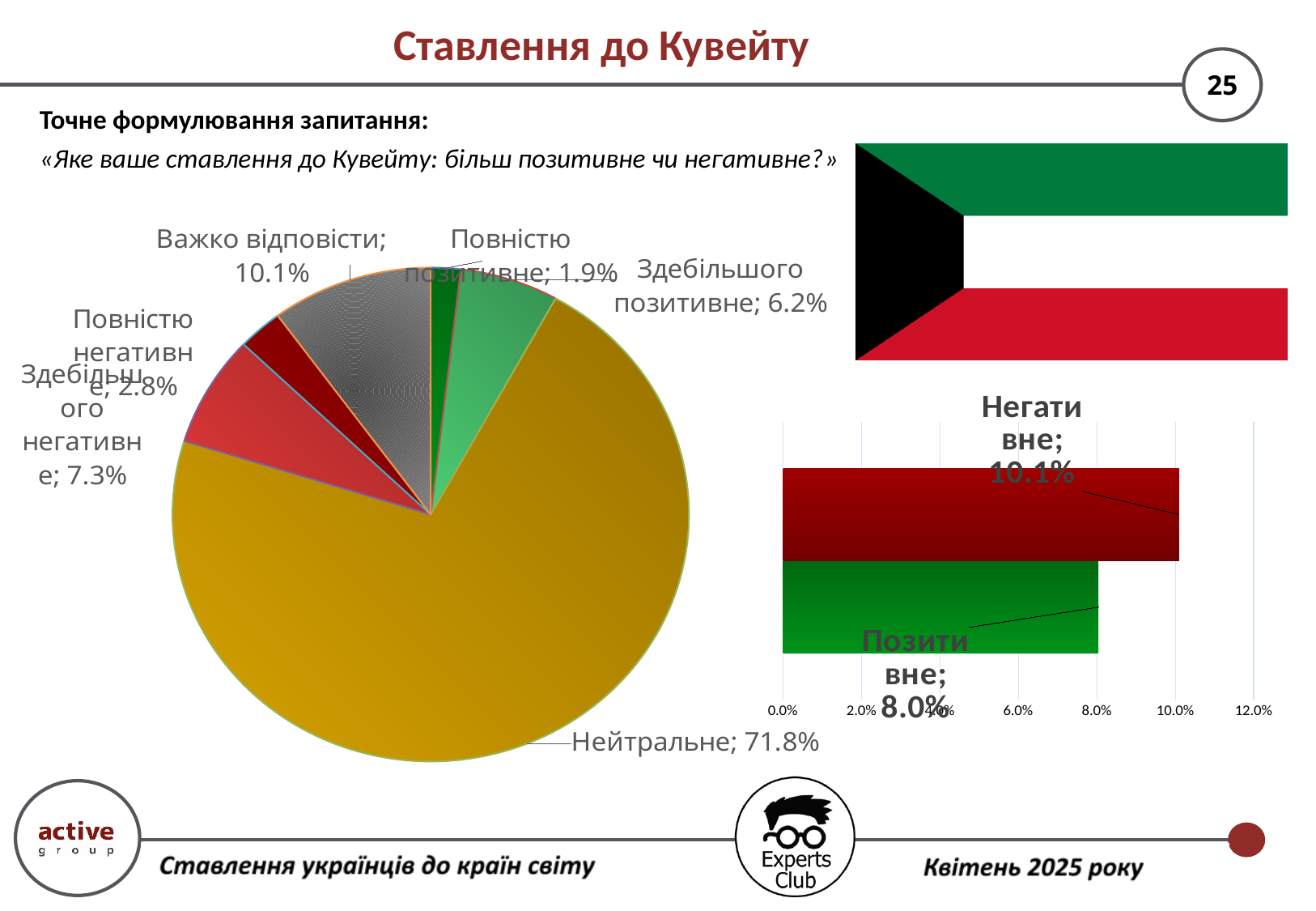
In the bar chart on the right, what is the value for Негативне? 10.1% In the pie chart, what share is labelled for Важко відповісти? 10.1% In the bar chart on the right, what is the value for Позитивне? 8.0% What kind of chart is shown on the right side of the slide below the flag? bar chart In the pie chart, which category has the largest slice? Нейтральне In the pie chart, how many slices are there? 6 In the pie chart, what share is labelled for Здебільшого позитивне? 6.2% In the pie chart, what share is labelled for Нейтральне? 71.8% In the pie chart, what share is labelled for Повністю позитивне? 1.9% In the pie chart, what is the difference between Здебільшого негативне and Повністю негативне? 4.5% In the bar chart on the right, which is larger, Негативне or Позитивне? Негативне In the pie chart, which category has the smallest slice? Повністю позитивне